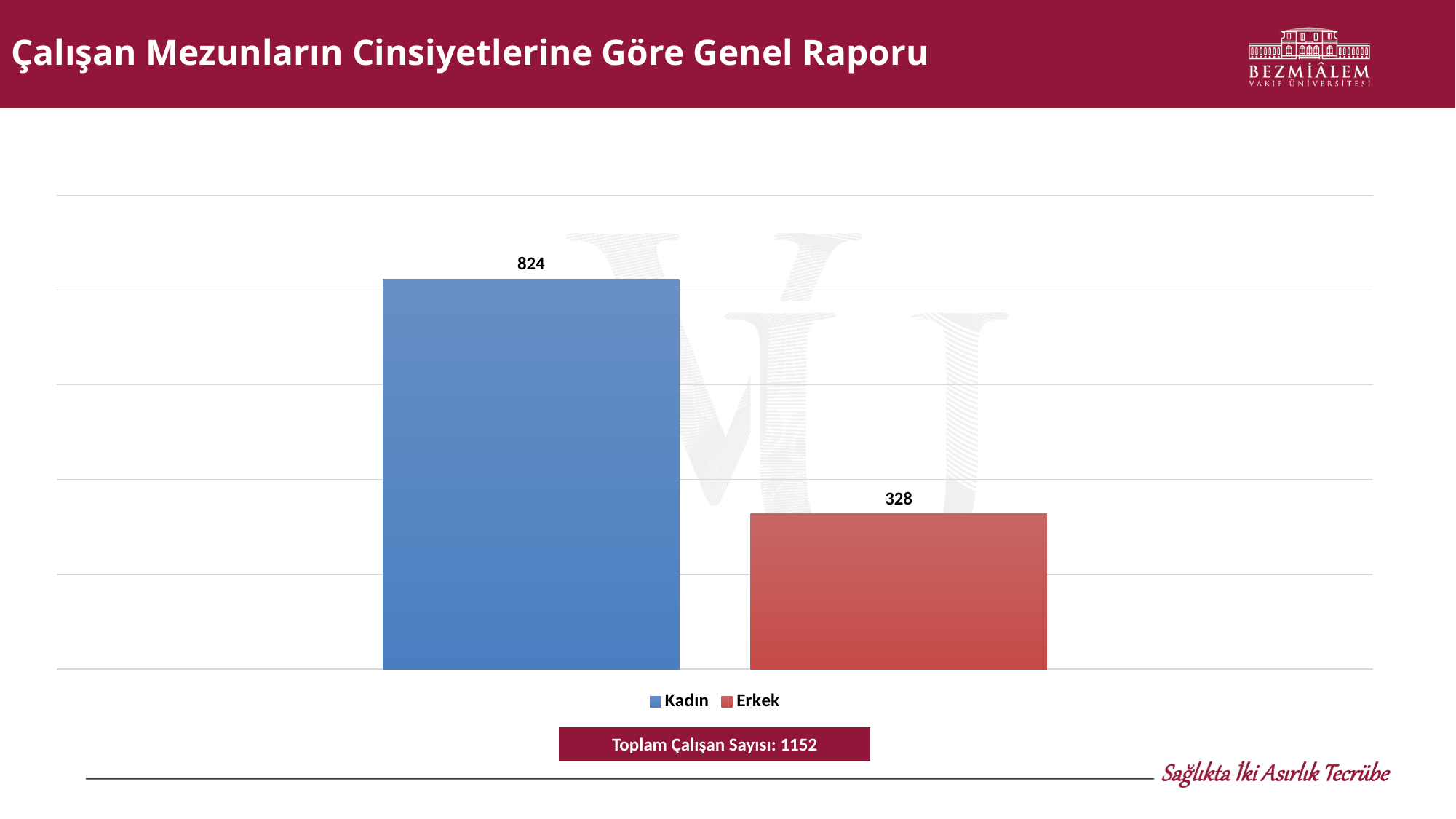
Which category has the lowest value? Erkek What is the value for Erkek? 328 How many bars are plotted in the chart? 2 Which is larger, the value for Kadın or the value for Erkek? Kadın What is the title of the slide? Çalışan Mezunların Cinsiyetlerine Göre Genel Raporu What colour is the bar for Kadın? Blue How many entries does the legend list? 2 Which category has the highest value? Kadın What is the value for Kadın? 824 What is the difference between the values for Kadın and Erkek? 496 What kind of chart is shown on the slide? Bar chart What is the total of the two bar values shown in the chart? 1152